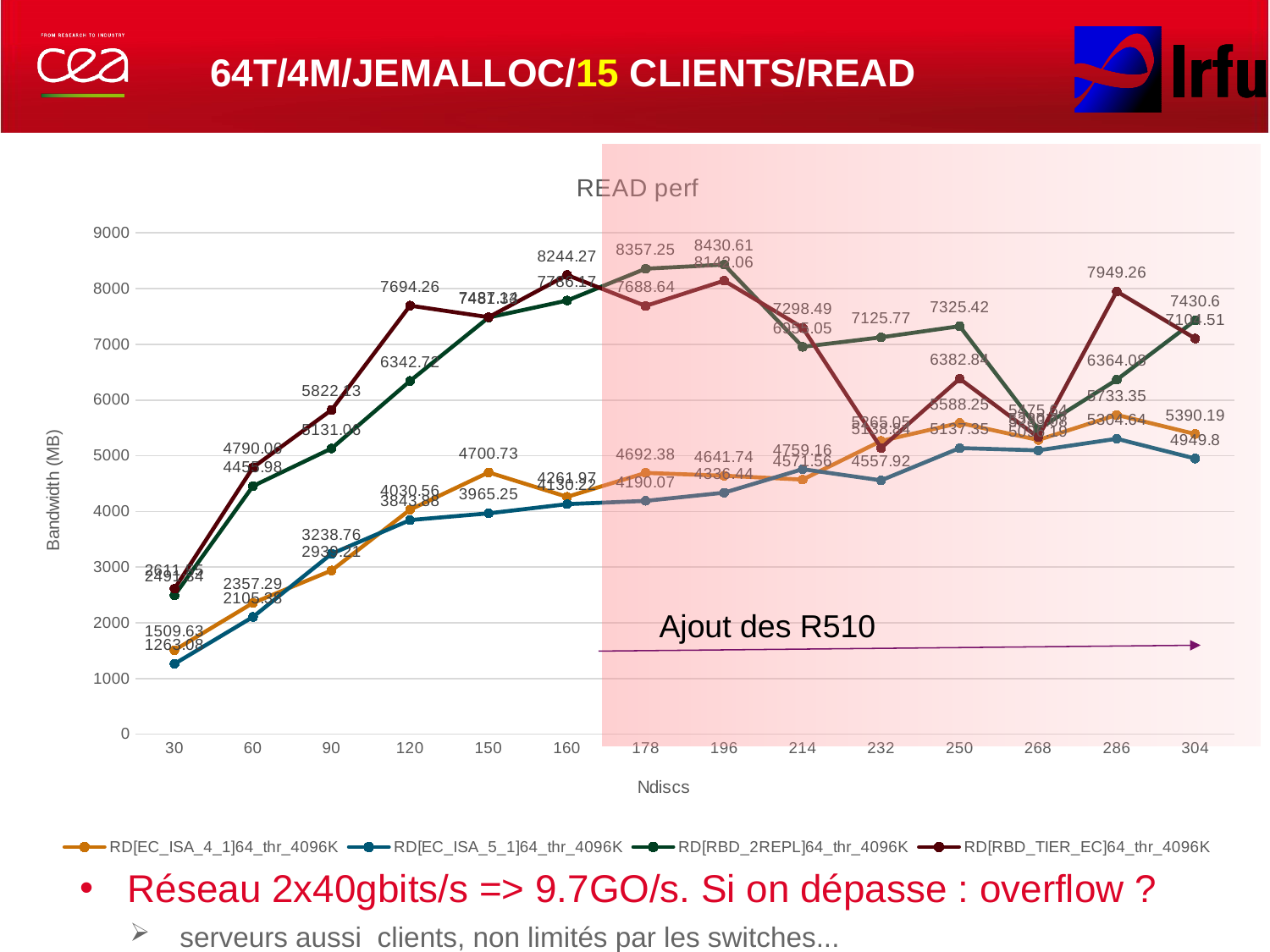
What is the difference between the bandwidth of RD[EC_ISA_4_1]64_thr_4096K and RD[EC_ISA_5_1]64_thr_4096K at 30 Ndiscs? 246.55 Which series has the lowest bandwidth at 30 Ndiscs? RD[EC_ISA_5_1]64_thr_4096K What is the title of the x axis of the READ perf chart? Ndiscs What is the bandwidth for RD[RBD_TIER_EC]64_thr_4096K at 160 Ndiscs? 8244.27 What is the bandwidth for RD[EC_ISA_4_1]64_thr_4096K at 30 Ndiscs? 1509.63 What is the bandwidth for RD[RBD_TIER_EC]64_thr_4096K at 120 Ndiscs? 7694.26 How many Ndiscs values are plotted along the x axis of the READ perf chart? 14 What is the bandwidth for RD[RBD_2REPL]64_thr_4096K at 196 Ndiscs? 8430.61 What kind of chart is shown on the slide? line chart Is the value for RD[RBD_2REPL]64_thr_4096K at 178 Ndiscs greater or less than 8000? greater How many series does the legend of the READ perf chart list? 4 At 286 Ndiscs, which is larger: RD[RBD_TIER_EC]64_thr_4096K or RD[RBD_2REPL]64_thr_4096K? RD[RBD_TIER_EC]64_thr_4096K